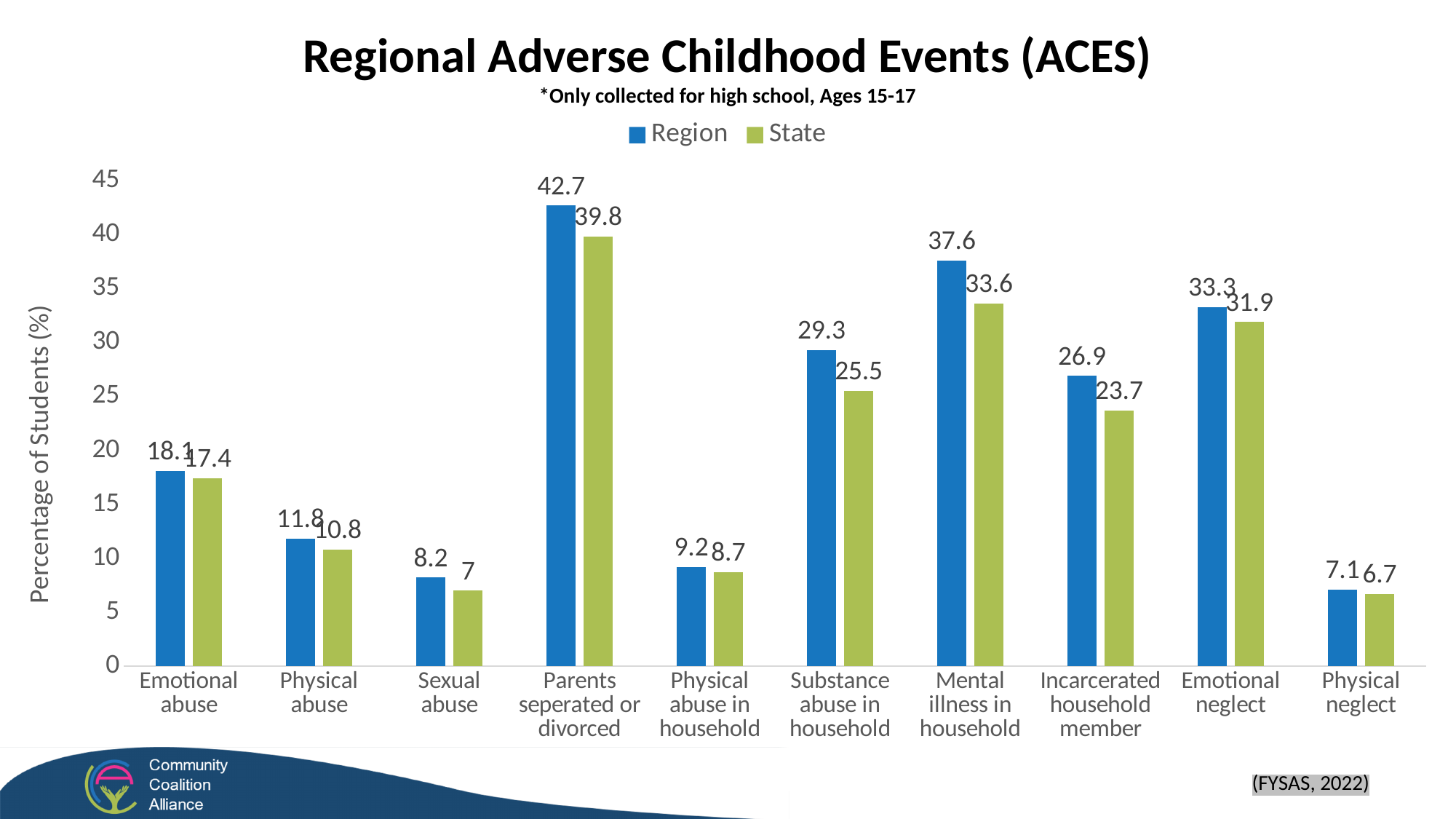
What is the title of the chart? Regional Adverse Childhood Events (ACES) What is the difference between the Region and State values for Substance abuse in household? 3.8 Is the Region value for Incarcerated household member greater or less than 25? greater What is the Region value for Parents seperated or divorced? 42.7 How many categories are shown on the x axis? 10 What kind of chart is shown on the slide? bar chart What is the Region value for Sexual abuse? 8.2 Which category has the highest Region value? Parents seperated or divorced Which category has the lowest State value? Physical neglect Which is larger, the Region value for Emotional neglect or the Region value for Mental illness in household? Mental illness in household What is the State value for Mental illness in household? 33.6 How many series does the legend list? 2